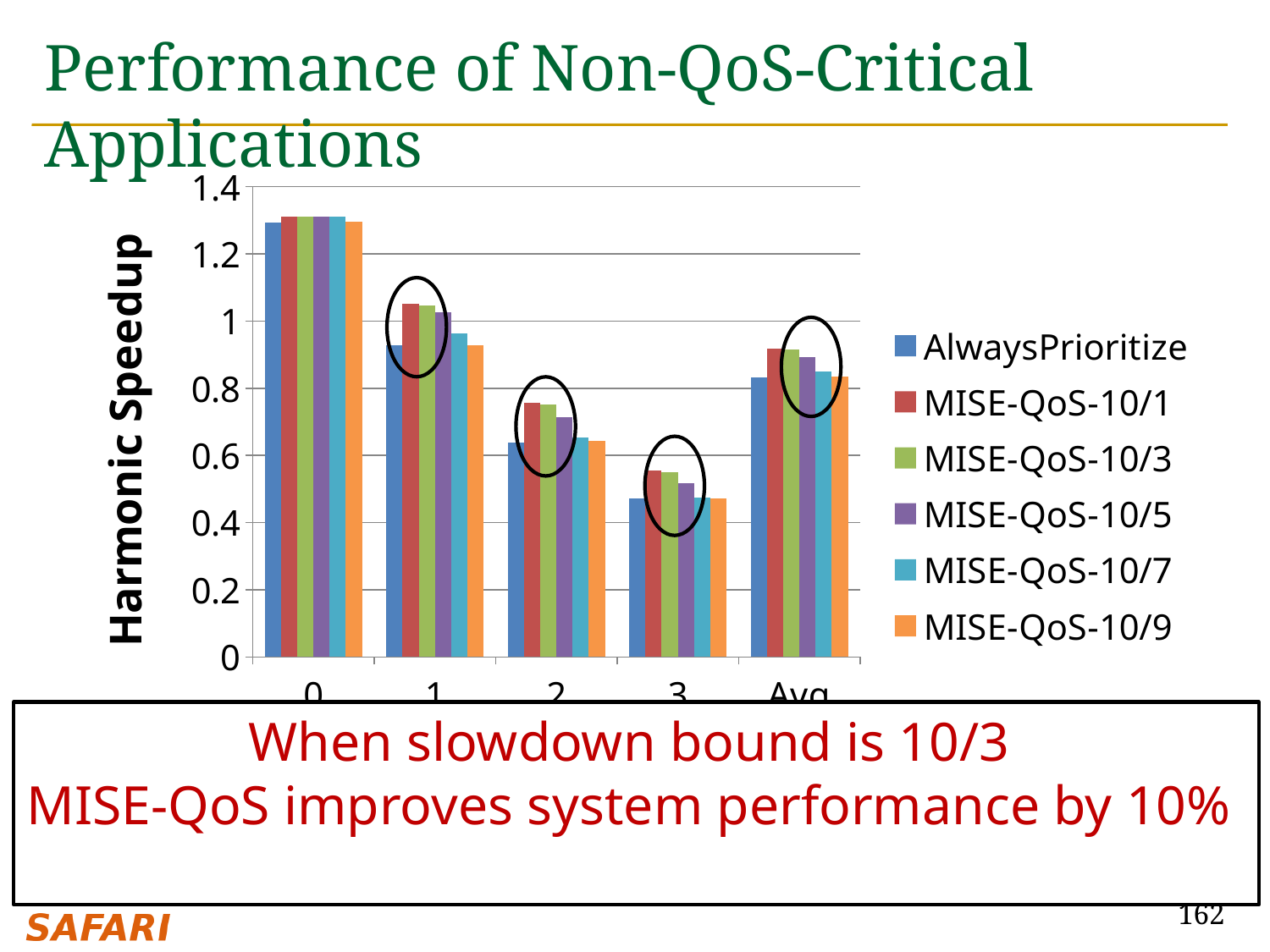
What is the label of the y axis? Harmonic Speedup Which series is listed first in the legend? AlwaysPrioritize Is the MISE-QoS-10/1 value for category 2 greater or less than 0.8? less Is the AlwaysPrioritize value for category 3 greater or less than 0.6? less Which category has the lowest MISE-QoS-10/3 value? 3 Is the MISE-QoS-10/1 value for category 1 greater or less than 1? greater How many series does the legend list? 6 Which category has the highest AlwaysPrioritize value? 0 What kind of chart is shown on the slide? bar chart How many categories are shown along the x axis? 5 For category 1, which is larger: the AlwaysPrioritize value or the MISE-QoS-10/1 value? MISE-QoS-10/1